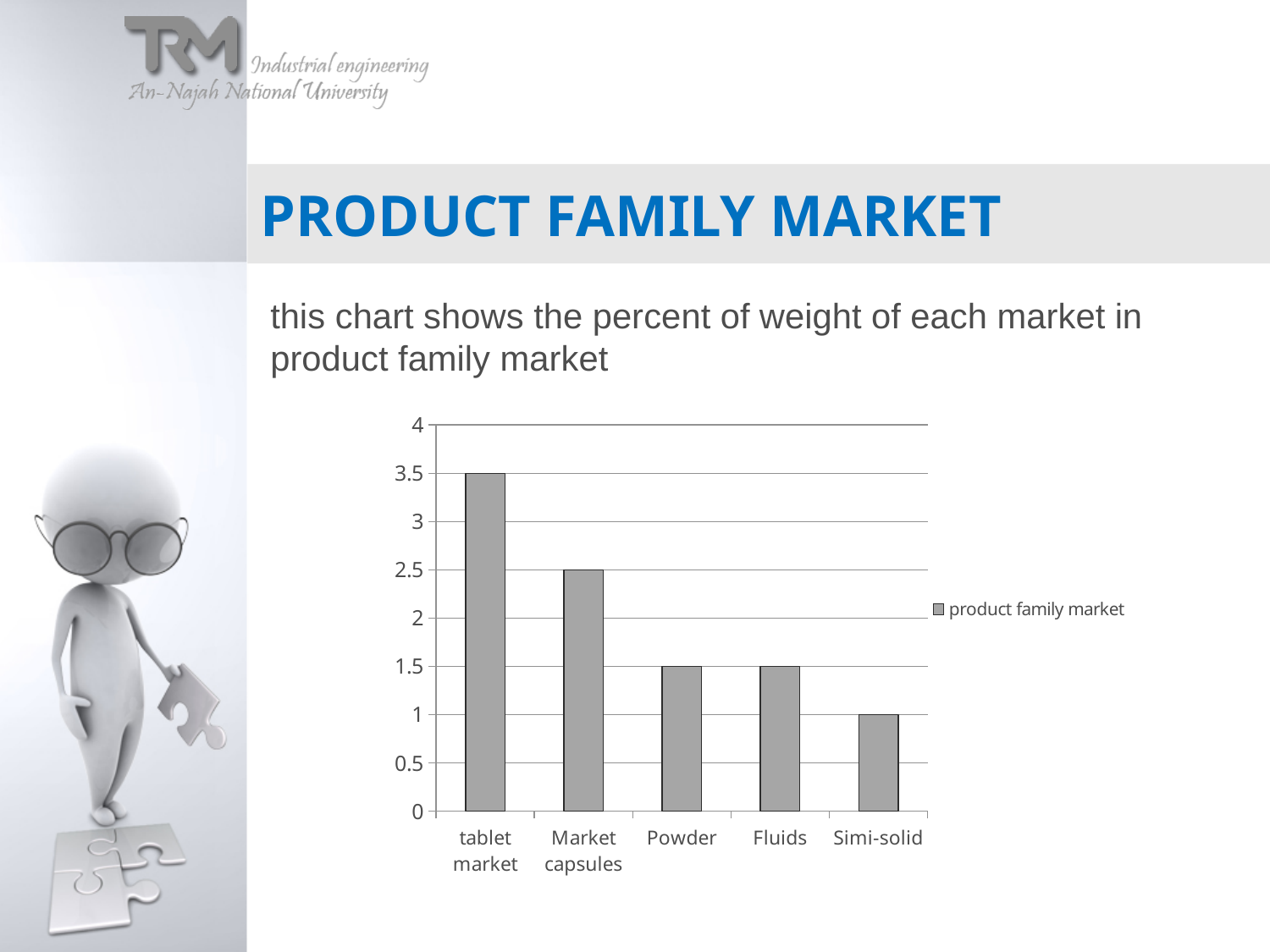
How many series does the chart legend list? 1 Which is larger, the value for Market capsules or the value for Powder? Market capsules What is the value for Simi-solid? 1 What is the difference between the values for tablet market and Market capsules? 1 Which category has the lowest value? Simi-solid Which category has the highest value? tablet market What is the value for tablet market? 3.5 What is the value for Market capsules? 2.5 What type of chart is shown on the slide? bar chart What is the name of the series shown in the chart legend? product family market How many categories are shown on the x axis of the chart? 5 Do the values rise or fall from left to right along the x axis? fall